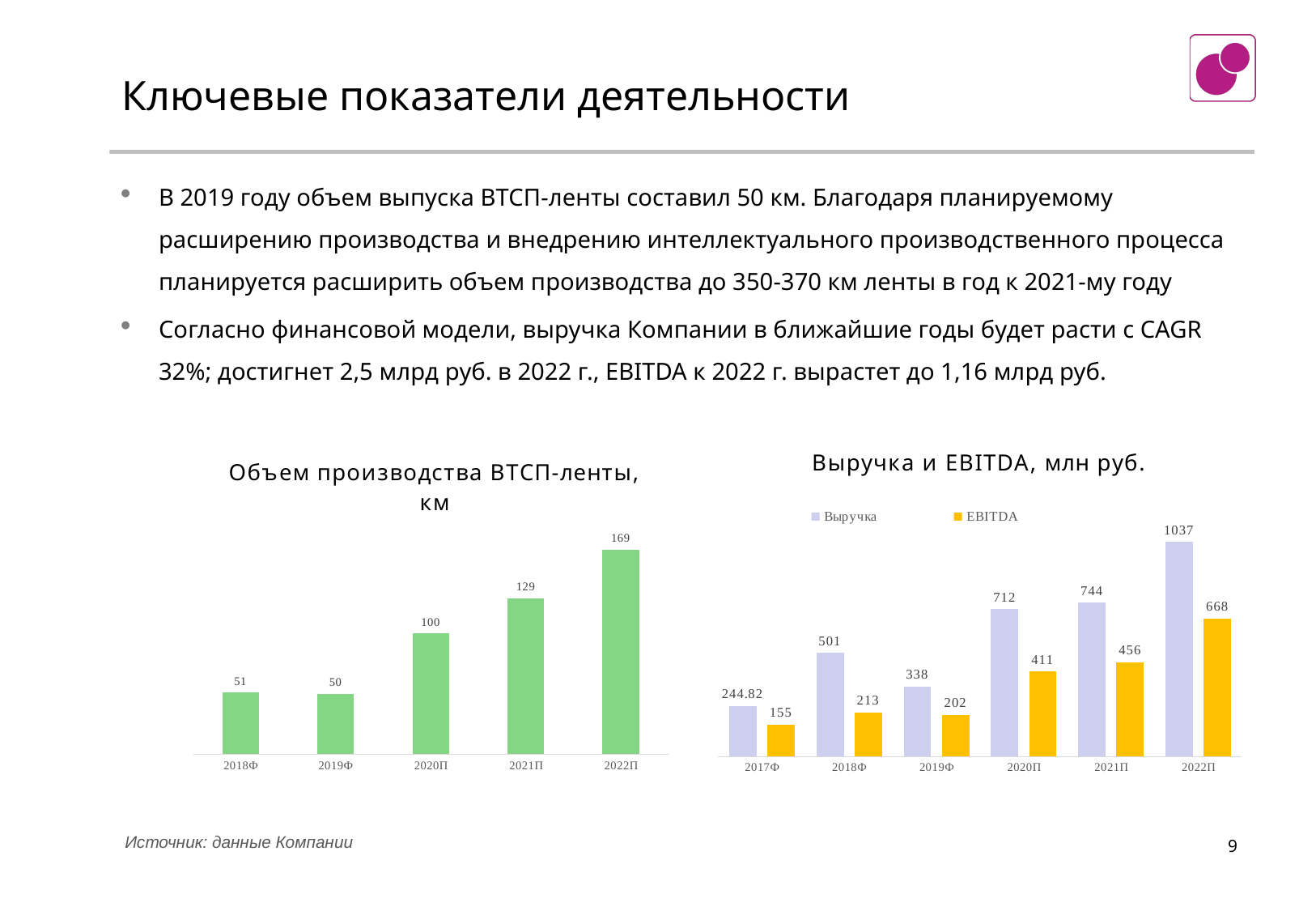
In the chart 'Объем производства ВТСП-ленты, км', how many years are shown on the x axis? 5 In the chart 'Объем производства ВТСП-ленты, км', what is the difference between the values for 2022П and 2020П? 69 In the chart 'Объем производства ВТСП-ленты, км', which year has the lowest value? 2019Ф In the chart 'Объем производства ВТСП-ленты, км', what is the value for 2021П? 129 How many series does the legend of the chart 'Выручка и EBITDA, млн руб.' list? 2 In the chart 'Выручка и EBITDA, млн руб.', which year has the highest Выручка value? 2022П In the chart 'Выручка и EBITDA, млн руб.', what colour are the EBITDA bars? Yellow In the chart 'Выручка и EBITDA, млн руб.', what is the Выручка value for 2017Ф? 244.82 In the chart 'Выручка и EBITDA, млн руб.', what is the EBITDA value for 2020П? 411 In the chart 'Выручка и EBITDA, млн руб.', which is larger: Выручка in 2018Ф or Выручка in 2019Ф? Выручка in 2018Ф In the chart 'Выручка и EBITDA, млн руб.', what is the difference between Выручка and EBITDA in 2022П? 369 What kind of chart is 'Объем производства ВТСП-ленты, км'? Bar chart